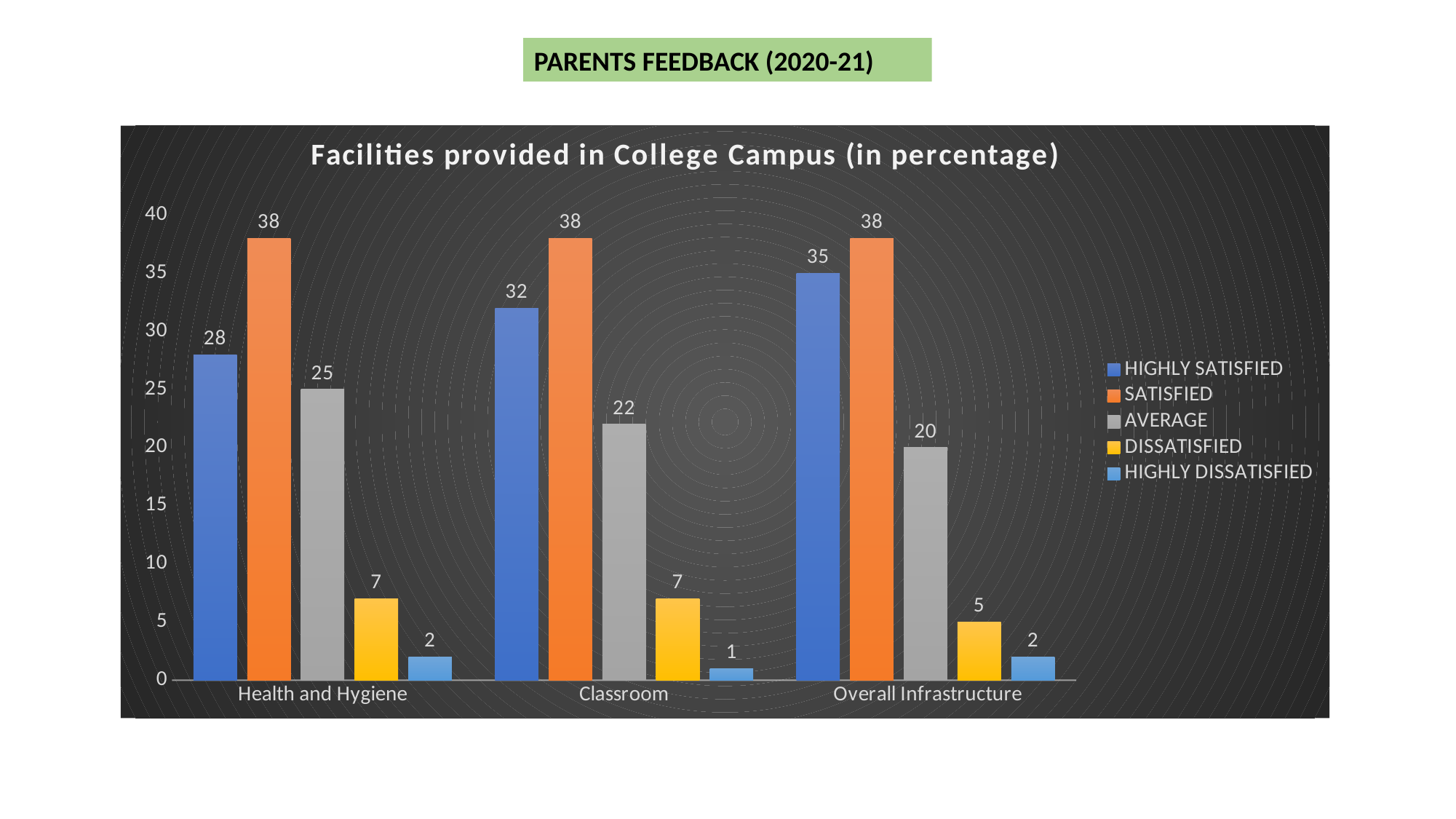
What is the difference between the HIGHLY SATISFIED values for Overall Infrastructure and Health and Hygiene? 7 Which category has the lowest AVERAGE value? Overall Infrastructure Which category has the highest HIGHLY SATISFIED value? Overall Infrastructure How many categories are shown on the x axis? 3 What is the title of the chart? Facilities provided in College Campus (in percentage) How many series does the legend list? 5 What kind of chart is shown on the slide? Bar chart What is the value for AVERAGE in the Classroom category? 22 Which is larger: the AVERAGE value for Health and Hygiene or the AVERAGE value for Classroom? Health and Hygiene What is the value for HIGHLY SATISFIED in the Health and Hygiene category? 28 What is the value for DISSATISFIED in the Overall Infrastructure category? 5 What is the value for HIGHLY DISSATISFIED in the Classroom category? 1